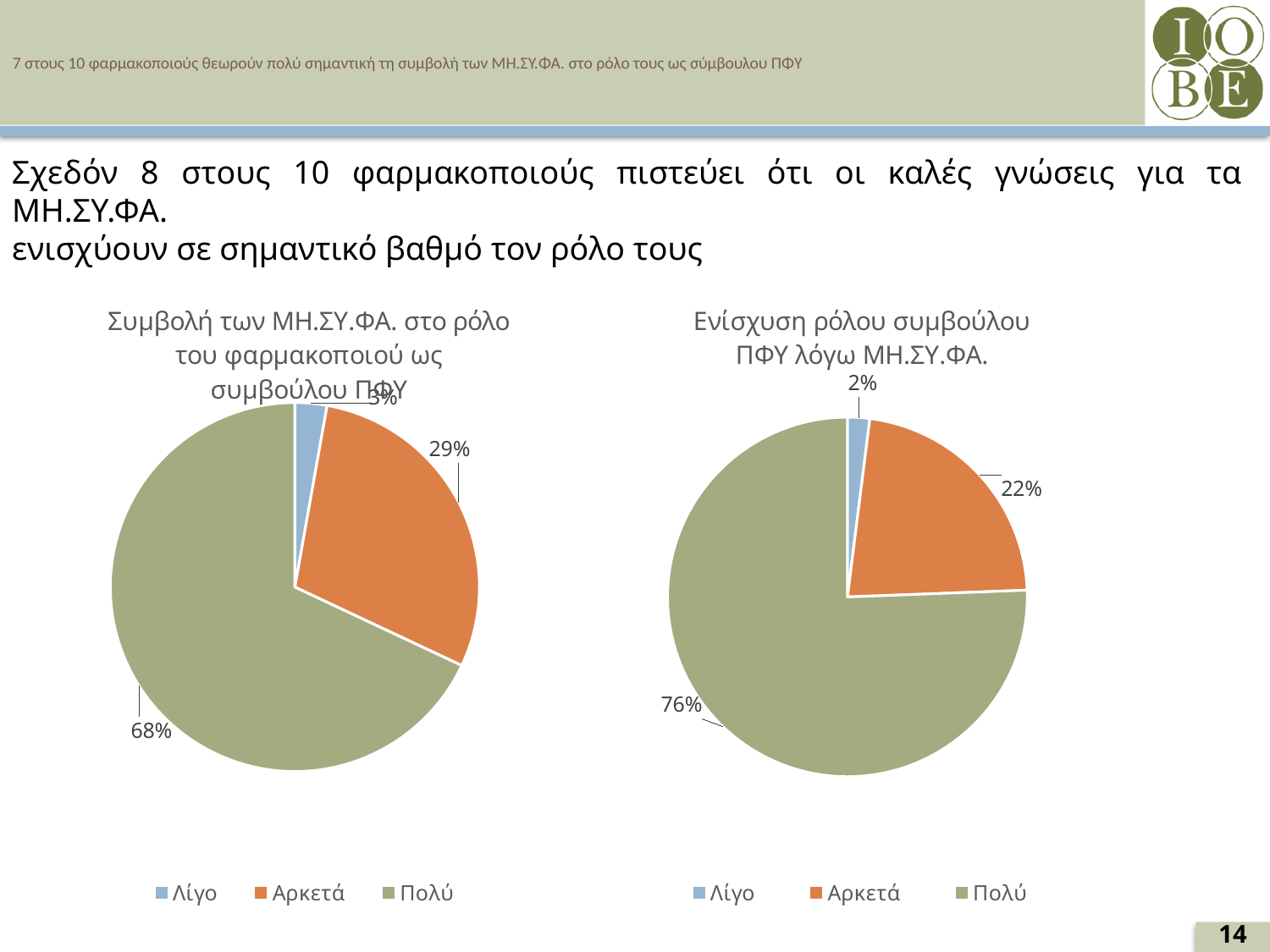
In the right pie chart (Ενίσχυση ρόλου συμβούλου ΠΦΥ λόγω ΜΗ.ΣΥ.ΦΑ.), which category has the smallest slice? Λίγο In the left pie chart (Συμβολή των ΜΗ.ΣΥ.ΦΑ. στο ρόλο του φαρμακοποιού ως συμβούλου ΠΦΥ), which category has the largest slice? Πολύ In the right pie chart (Ενίσχυση ρόλου συμβούλου ΠΦΥ λόγω ΜΗ.ΣΥ.ΦΑ.), what share is labelled for Πολύ? 76% In the left pie chart (Συμβολή των ΜΗ.ΣΥ.ΦΑ. στο ρόλο του φαρμακοποιού ως συμβούλου ΠΦΥ), what share is labelled for Πολύ? 68% Which chart has the larger share for Πολύ, the left pie chart or the right pie chart? The right pie chart In the left pie chart (Συμβολή των ΜΗ.ΣΥ.ΦΑ. στο ρόλο του φαρμακοποιού ως συμβούλου ΠΦΥ), what share is labelled for Αρκετά? 29% In the right pie chart (Ενίσχυση ρόλου συμβούλου ΠΦΥ λόγω ΜΗ.ΣΥ.ΦΑ.), what share is labelled for Λίγο? 2% In the right pie chart (Ενίσχυση ρόλου συμβούλου ΠΦΥ λόγω ΜΗ.ΣΥ.ΦΑ.), what share is labelled for Αρκετά? 22% How many categories does the legend of the left pie chart list? 3 In the left pie chart, which colour represents the Αρκετά category? Orange In the right pie chart (Ενίσχυση ρόλου συμβούλου ΠΦΥ λόγω ΜΗ.ΣΥ.ΦΑ.), what is the difference between the Πολύ and Αρκετά shares? 54% What type of chart is the right chart (Ενίσχυση ρόλου συμβούλου ΠΦΥ λόγω ΜΗ.ΣΥ.ΦΑ.)? Pie chart